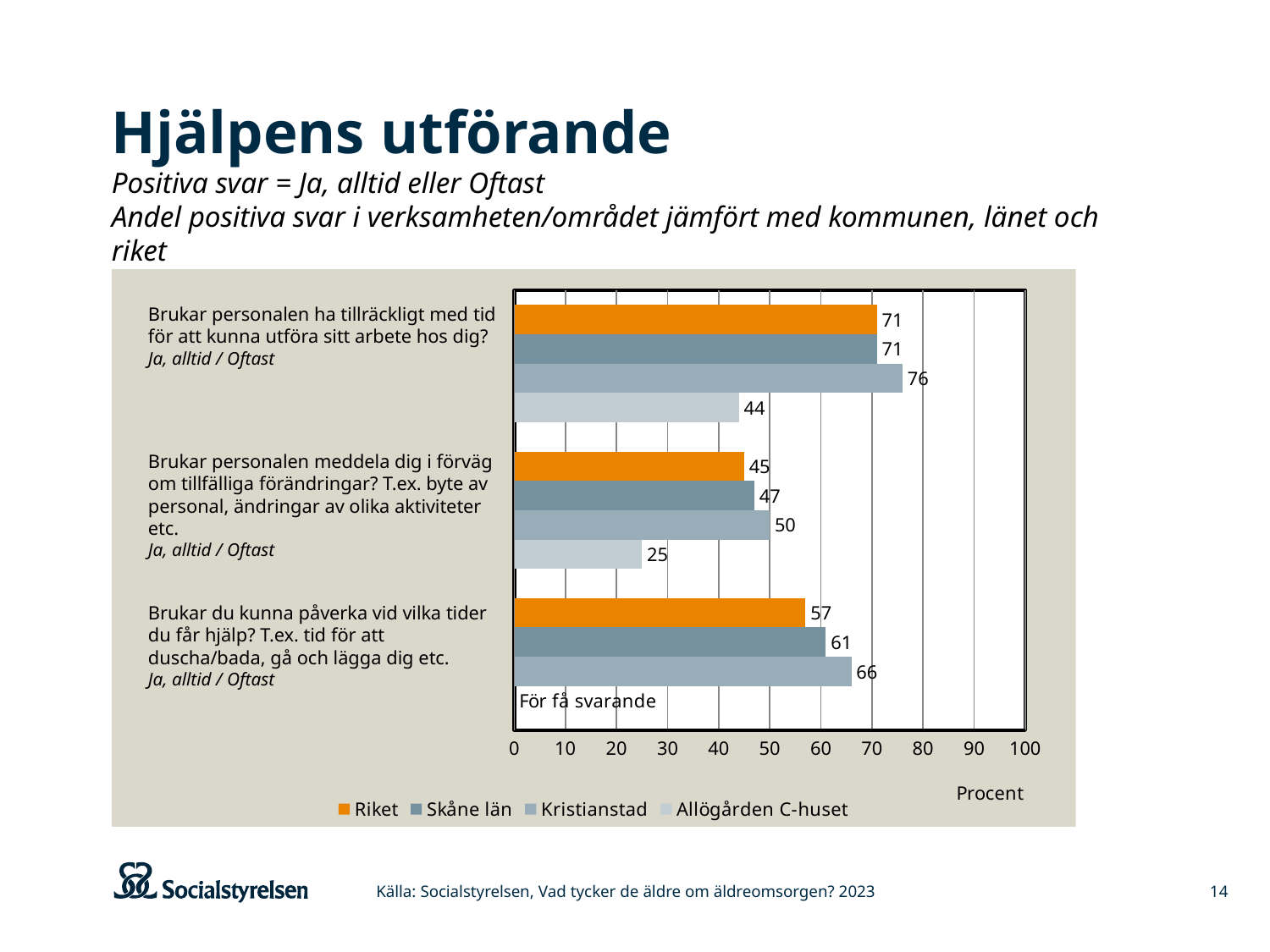
What is the label of the x axis? Procent What is shown instead of a bar for Allögården C-huset for the question 'Brukar du kunna påverka vid vilka tider du får hjälp?'? För få svarande What is the value for Skåne län for the question 'Brukar personalen meddela dig i förväg om tillfälliga förändringar?'? 47 Which is larger for the question 'Brukar du kunna påverka vid vilka tider du får hjälp?': Riket or Skåne län? Skåne län Which series has the highest value for the question 'Brukar du kunna påverka vid vilka tider du får hjälp?'? Kristianstad How many series does the legend list? 4 What is the value for Riket for the question 'Brukar du kunna påverka vid vilka tider du får hjälp?'? 57 What is the value for Kristianstad for the question 'Brukar personalen ha tillräckligt med tid för att kunna utföra sitt arbete hos dig?'? 76 What type of chart is shown on the slide? Bar chart What is the difference between Kristianstad and Allögården C-huset for the question 'Brukar personalen ha tillräckligt med tid för att kunna utföra sitt arbete hos dig?'? 32 What is the value for Allögården C-huset for the question 'Brukar personalen meddela dig i förväg om tillfälliga förändringar?'? 25 Which series has the lowest value for the question 'Brukar personalen ha tillräckligt med tid för att kunna utföra sitt arbete hos dig?'? Allögården C-huset